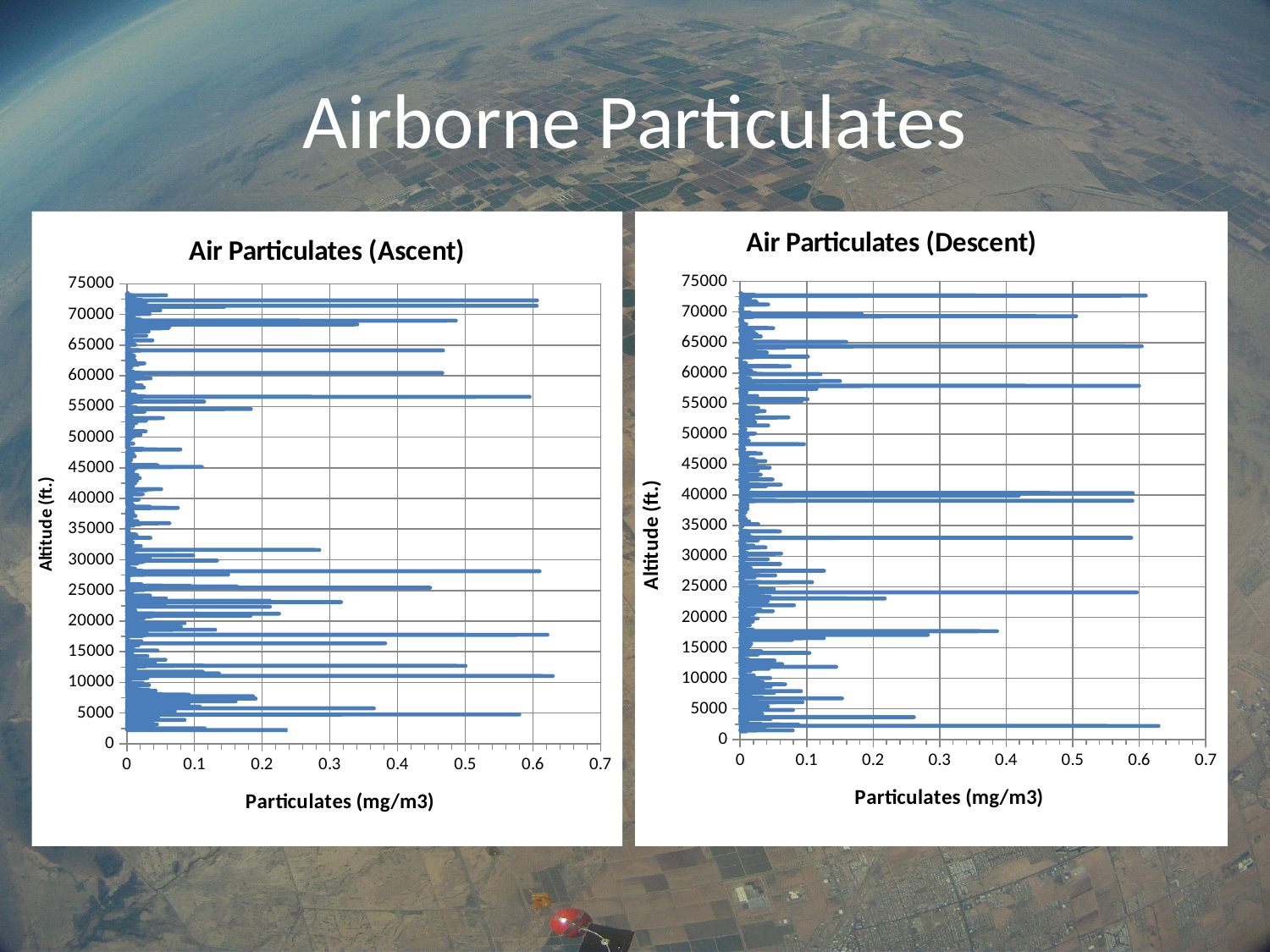
What kind of chart is the Air Particulates (Descent) chart? bar chart What is the y-axis label on the Air Particulates (Descent) chart? Altitude (ft.) On the Air Particulates (Descent) chart, is the largest particulate value greater or less than 0.5? greater What is the x-axis label on the Air Particulates (Ascent) chart? Particulates (mg/m3) On the Air Particulates (Ascent) chart, is the largest particulate value greater or less than 0.5? greater What kind of chart is the Air Particulates (Ascent) chart? bar chart On the Air Particulates (Ascent) chart, is the largest particulate value greater or less than 0.7? less